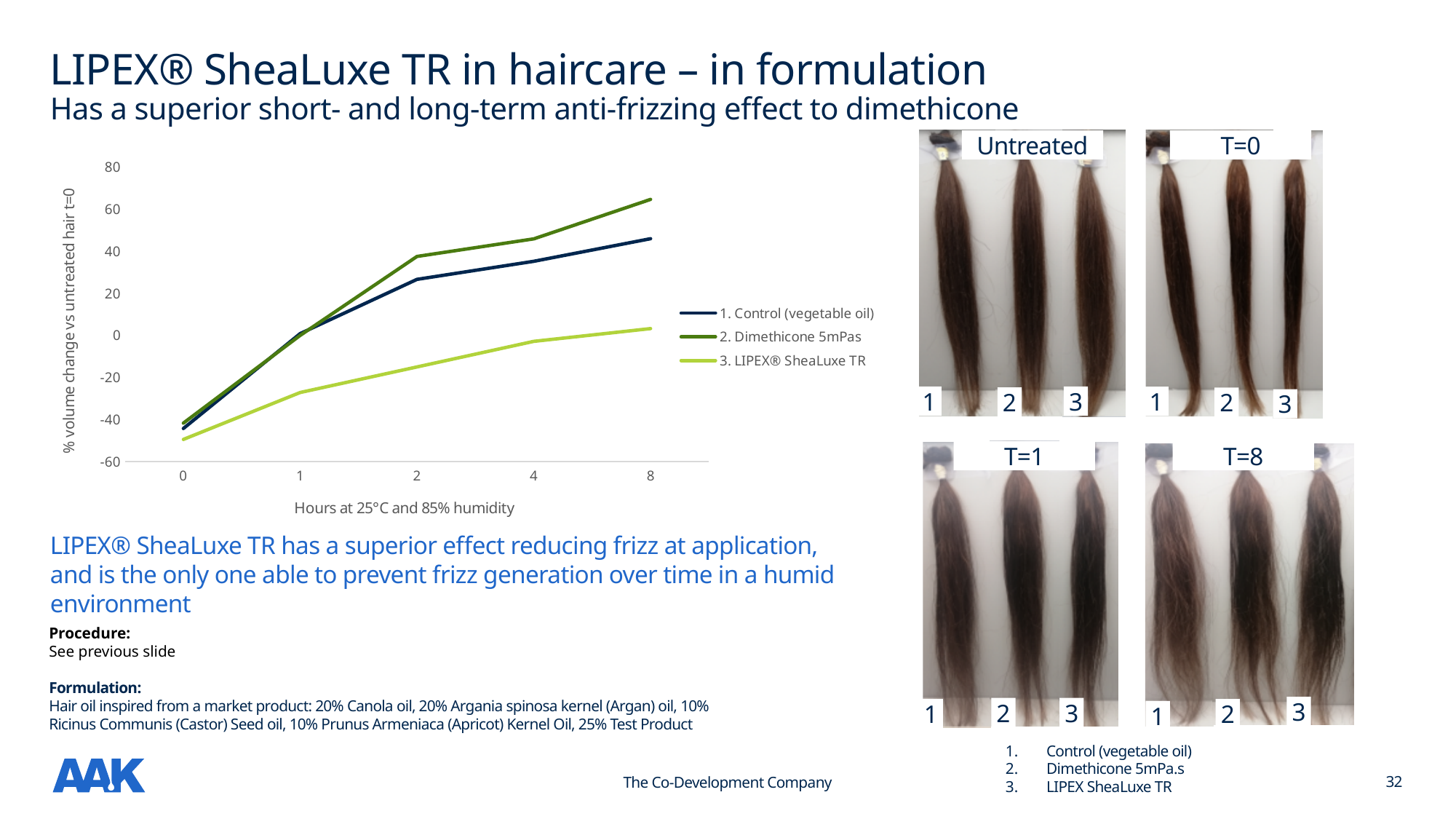
Is the value for 2. Dimethicone 5mPas at 8 hours greater or less than 60? greater What kind of chart is shown on the slide? line chart What is the title of the chart's x axis? Hours at 25°C and 85% humidity How many time points are shown on the x axis of the chart? 5 Is the value for 1. Control (vegetable oil) at 0 hours greater or less than -20? less Which series has the highest value at 8 hours? 2. Dimethicone 5mPas Is the value for 3. LIPEX® SheaLuxe TR at 2 hours greater or less than 0? less Which series has the lowest value at 8 hours? 3. LIPEX® SheaLuxe TR Do the values for 2. Dimethicone 5mPas rise or fall as the hours increase along the x axis? rise At 4 hours, which is larger: the value for 2. Dimethicone 5mPas or the value for 3. LIPEX® SheaLuxe TR? 2. Dimethicone 5mPas How many series does the chart's legend list? 3